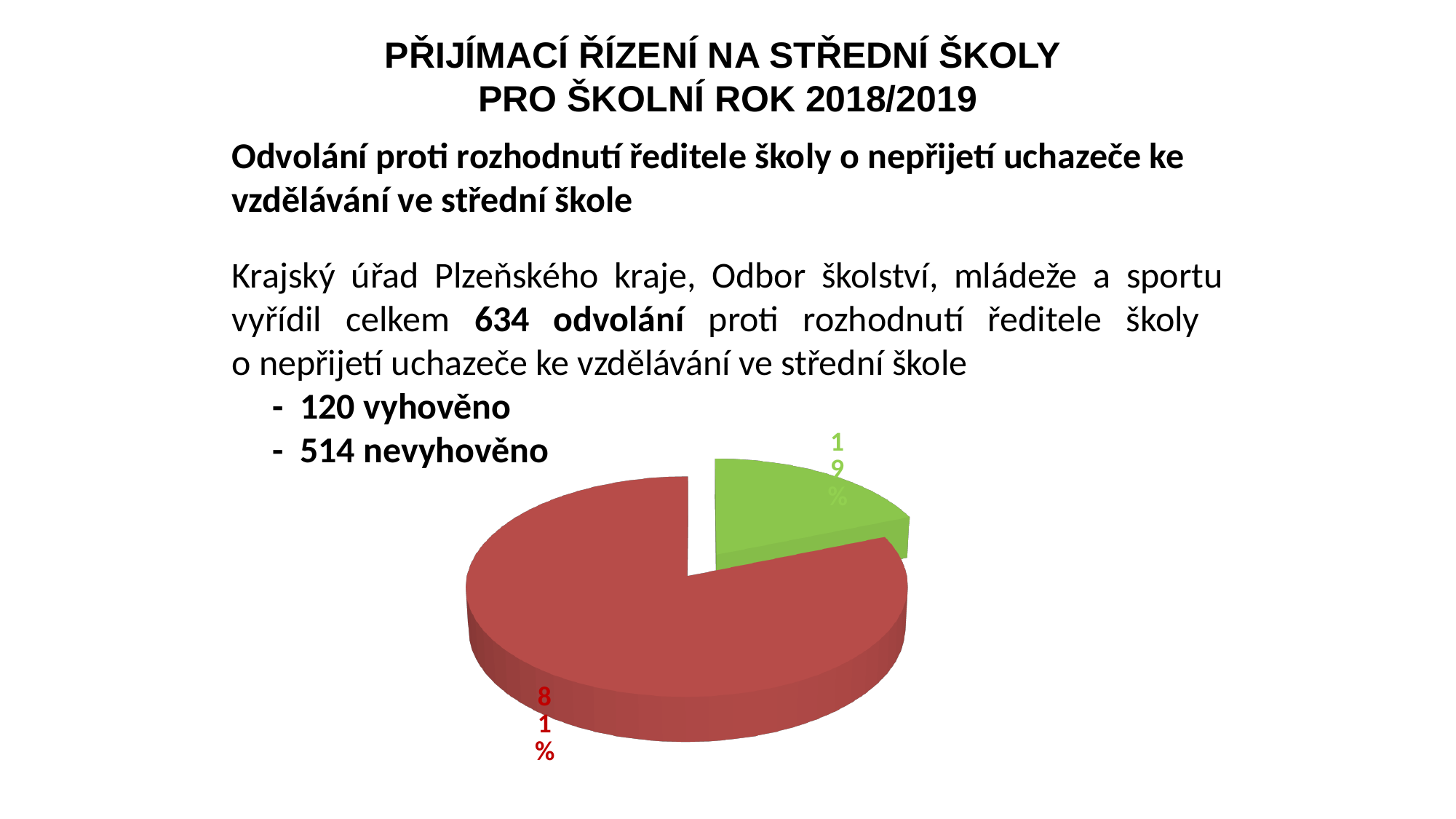
What percentage is shown on the red slice of the pie chart? 81% What colour is the slice labelled 81%? red What is the difference in percentage points between the red slice and the green slice? 62 What kind of chart is shown on the slide? pie chart Which slice of the pie chart is pulled out (exploded) from the rest? the green slice How many slices does the pie chart have? 2 What percentage is shown on the green slice of the pie chart? 19% What share of the pie does the green slice represent? 19% Which slice of the pie chart is the largest? the red slice (81%) What do the two slice percentages on the pie chart add up to? 100% Which slice of the pie chart is the smallest? the green slice (19%) Which slice is larger, the red one or the green one? the red one